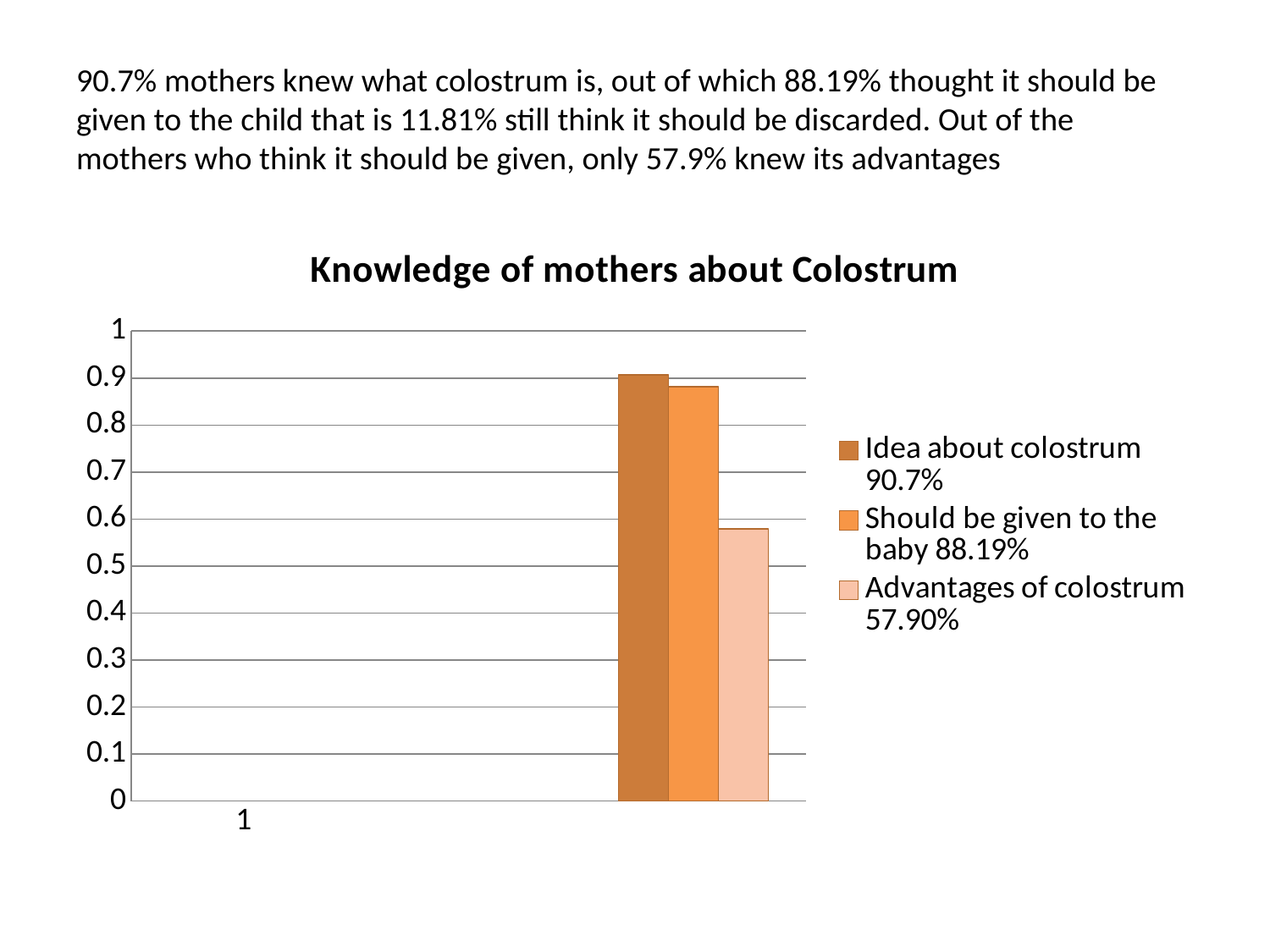
What value does the legend give for 'Idea about colostrum'? 90.7% What type of chart is shown on the slide? Bar chart Is the bar for 'Advantages of colostrum' greater or less than 0.5 on the axis? greater Which is larger, the value for 'Should be given to the baby' or the value for 'Advantages of colostrum'? Should be given to the baby How many bars are plotted in the chart? 3 Which series has the highest bar in the chart? Idea about colostrum What is the title of the chart? Knowledge of mothers about Colostrum What is the difference between the 'Idea about colostrum' value and the 'Advantages of colostrum' value? 32.8 percentage points What value does the legend give for 'Should be given to the baby'? 88.19% What value does the legend give for 'Advantages of colostrum'? 57.90% Which series has the lowest bar in the chart? Advantages of colostrum How many series does the chart legend list? 3